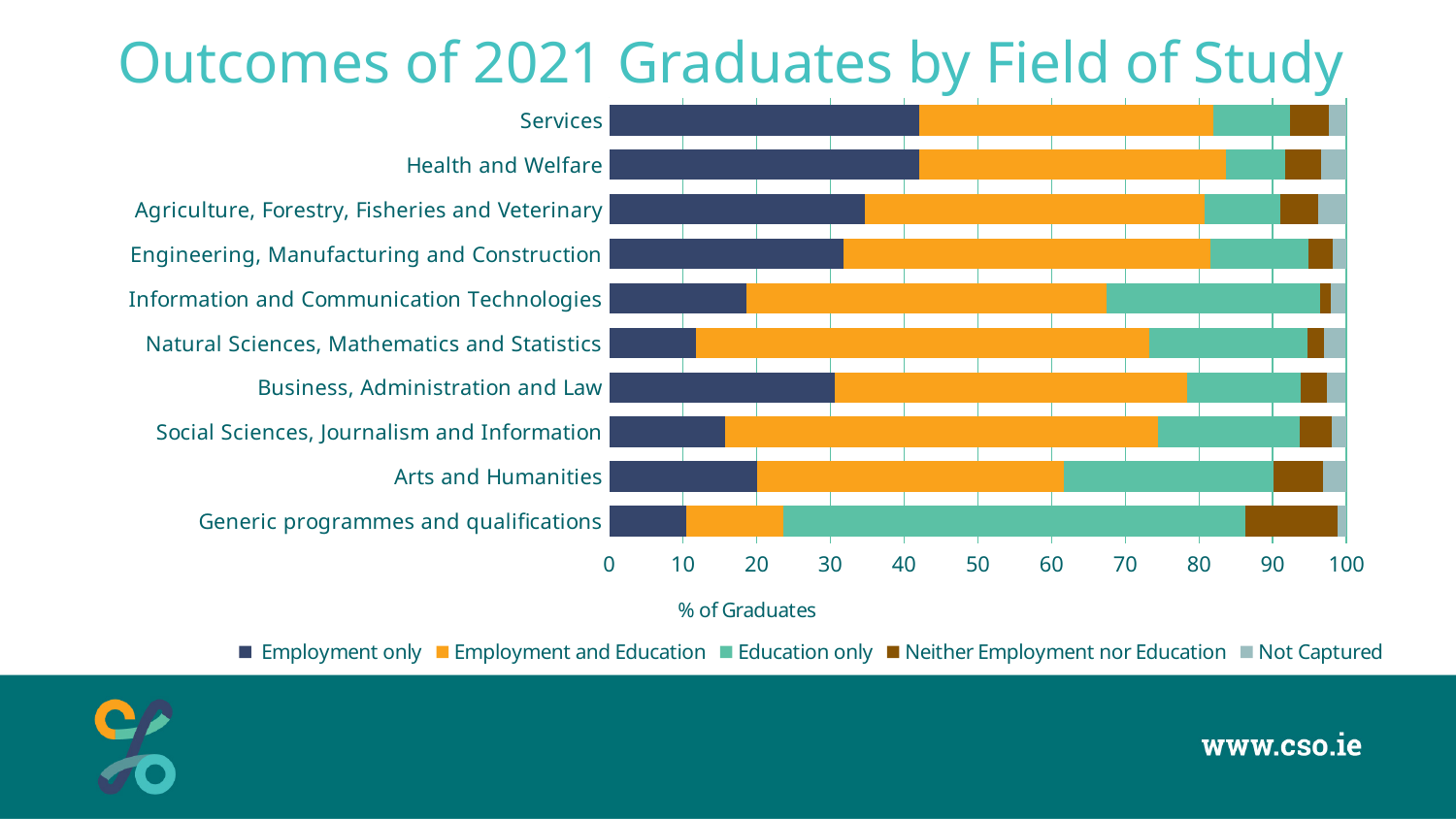
What is the label on the horizontal axis? % of Graduates How many fields of study are shown on the chart? 10 What is the title of the chart? Outcomes of 2021 Graduates by Field of Study What kind of chart is shown on the slide? Stacked bar chart Is the 'Employment only' value for Generic programmes and qualifications greater or less than 20? less Which has the larger 'Education only' share: Generic programmes and qualifications or Services? Generic programmes and qualifications Which field of study has the largest 'Neither Employment nor Education' share? Generic programmes and qualifications Is the 'Employment only' value for Services greater or less than 40? greater Is the 'Employment only' value for Natural Sciences, Mathematics and Statistics greater or less than 20? less How many series does the legend list? 5 Which field of study has the largest 'Education only' share? Generic programmes and qualifications Which has the larger 'Employment only' share: Engineering, Manufacturing and Construction or Social Sciences, Journalism and Information? Engineering, Manufacturing and Construction